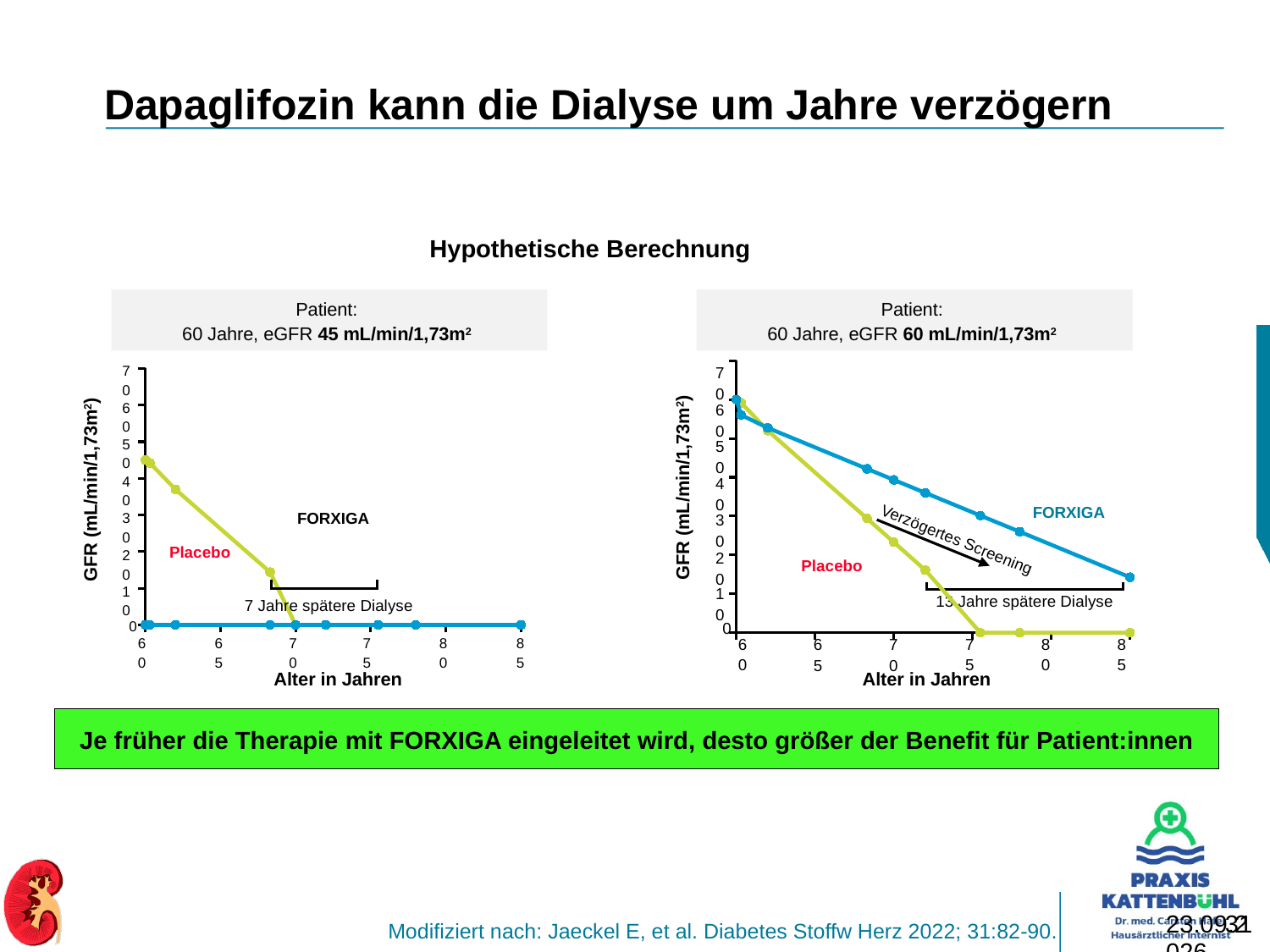
What is the x-axis label of the right chart (eGFR 60)? Alter in Jahren On the right chart (eGFR 60), is the Placebo value at age 70 greater or less than 30? less On the right chart (eGFR 60), does the Placebo line rise or fall as age increases? fall How many series are plotted on the right chart (Patient 60 Jahre, eGFR 60 mL/min/1,73m²)? 2 On the right chart (eGFR 60), is the FORXIGA value at age 85 greater or less than 20? less On the left chart (eGFR 45), what is the GFR value of the Placebo line at age 60? 45 mL/min/1,73m² What annotation text is shown below the bracket on the left chart (eGFR 45)? 7 Jahre spätere Dialyse What kind of chart is used on the left chart (Patient 60 Jahre, eGFR 45 mL/min/1,73m²)? line chart On the right chart (eGFR 60), what is the GFR value at age 60? 60 mL/min/1,73m² On the right chart (eGFR 60), which series has the higher GFR at age 75, FORXIGA or Placebo? FORXIGA On the left chart (eGFR 45), is the Placebo value at age 65 greater or less than 30? less How many tick labels are shown on the x axis of the left chart (eGFR 45)? 6